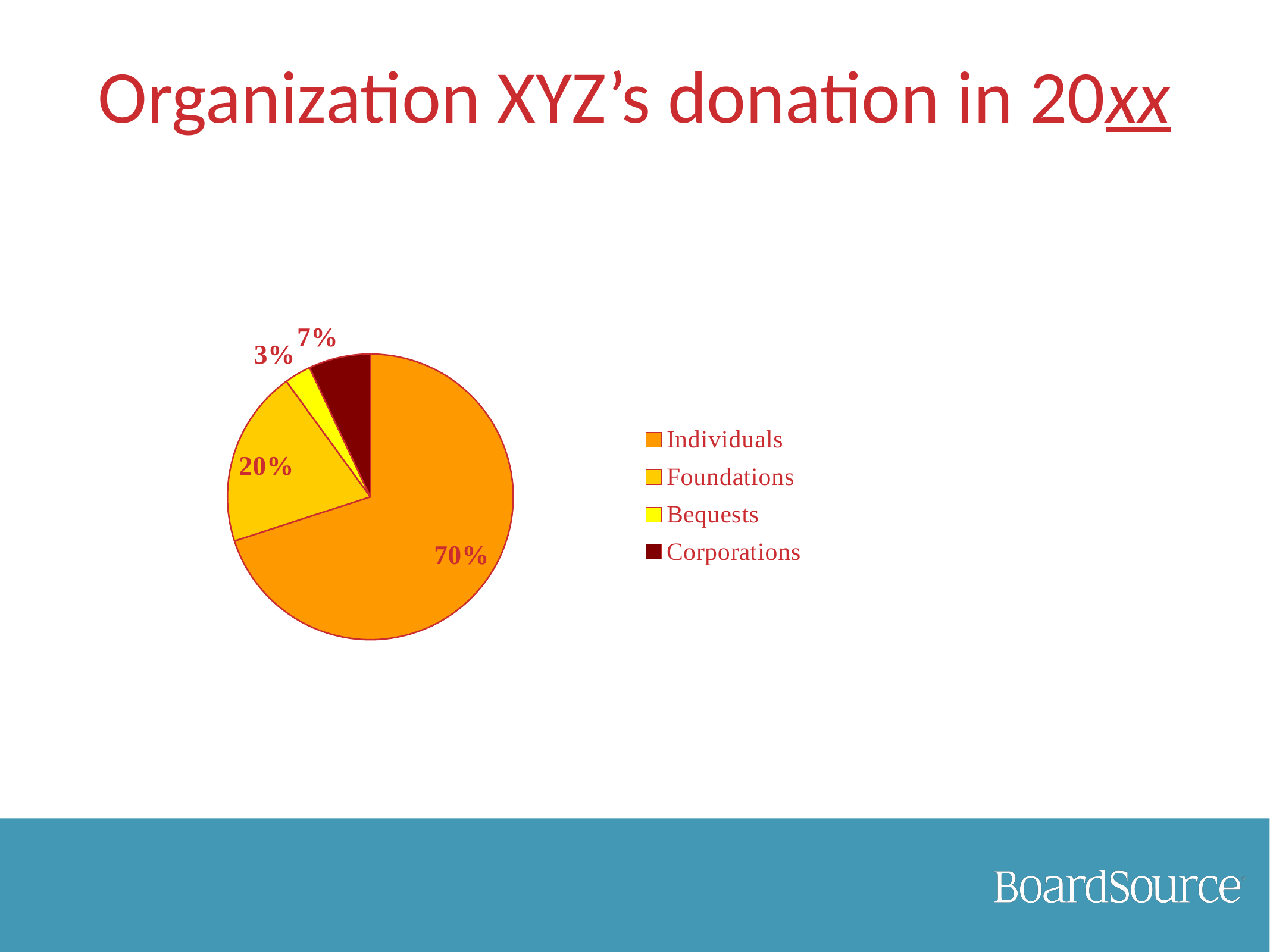
What is the difference in percentage points between Corporations and Bequests? 4 What share of the pie does Bequests account for? 3% How many categories does the pie chart have? 4 What share of the pie does Foundations account for? 20% Which is larger, the share for Foundations or the share for Corporations? Foundations What share of the pie does Individuals account for? 70% What kind of chart is shown on the slide? pie chart Which category has the smallest slice of the pie? Bequests Which category has the largest slice of the pie? Individuals What is the title of the slide containing the chart? Organization XYZ's donation in 20xx What is the difference in percentage points between Individuals and Foundations? 50